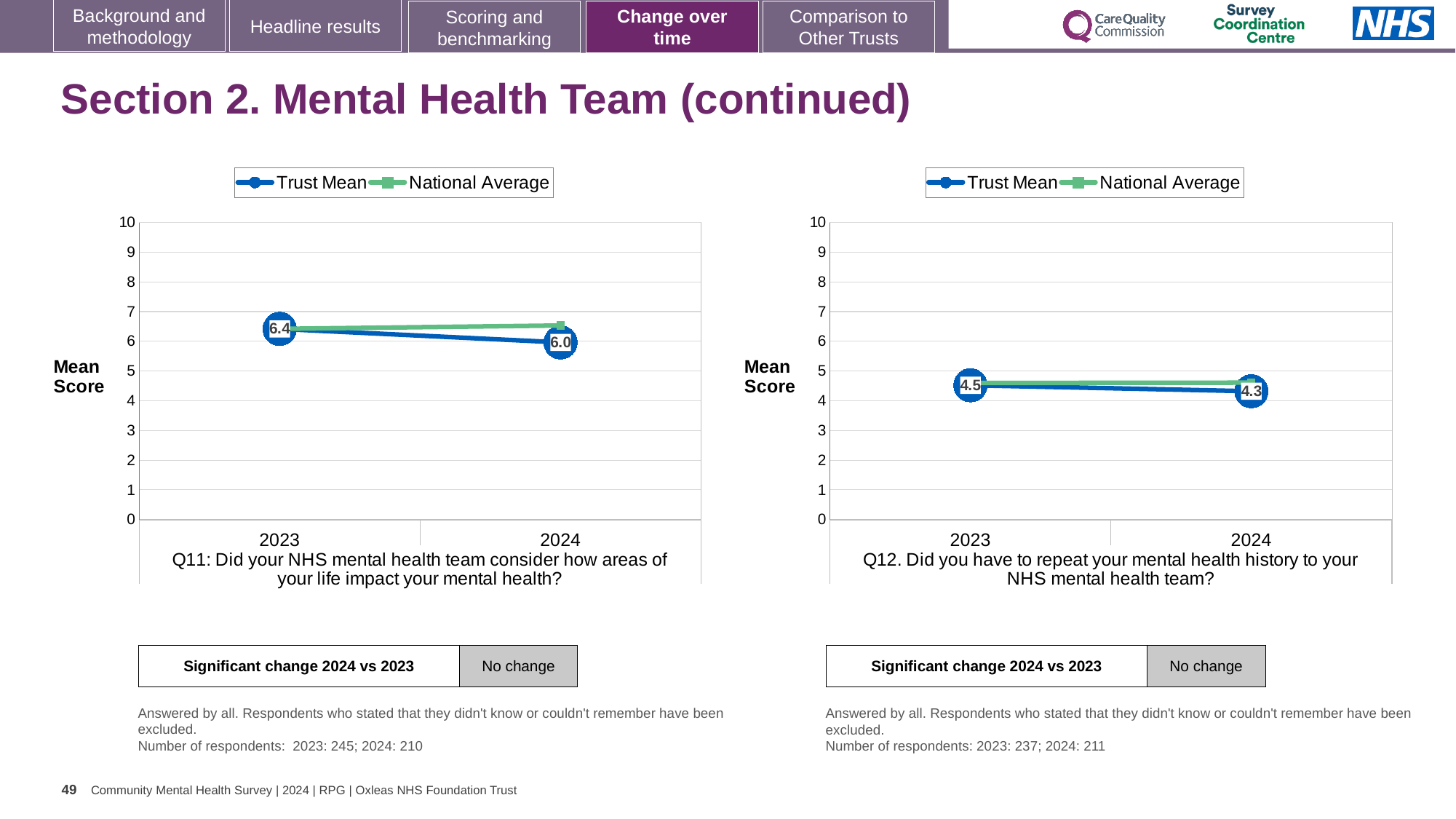
In the left chart (Q11), by how much did the Trust Mean change from 2023 to 2024? 0.4 In the right chart (Q12), what is the Trust Mean for 2024? 4.3 In the left chart (Q11), does the Trust Mean rise or fall from 2023 to 2024? fall In the left chart (Q11), what is the Trust Mean for 2024? 6.0 In the right chart (Q12), what is the difference between the Trust Mean in 2023 and in 2024? 0.2 In the right chart (Q12), is the Trust Mean for 2024 greater or less than 5? less In the left chart (Q11), what is the Trust Mean for 2023? 6.4 How many years are plotted on the x axis of the left chart (Q11)? 2 In the right chart (Q12), what is the Trust Mean for 2023? 4.5 In the left chart (Q11), is the National Average for 2024 greater or less than 6? greater How many series does the legend of the right chart (Q12) list? 2 What kind of chart is used on the left of the slide (Q11)? line chart